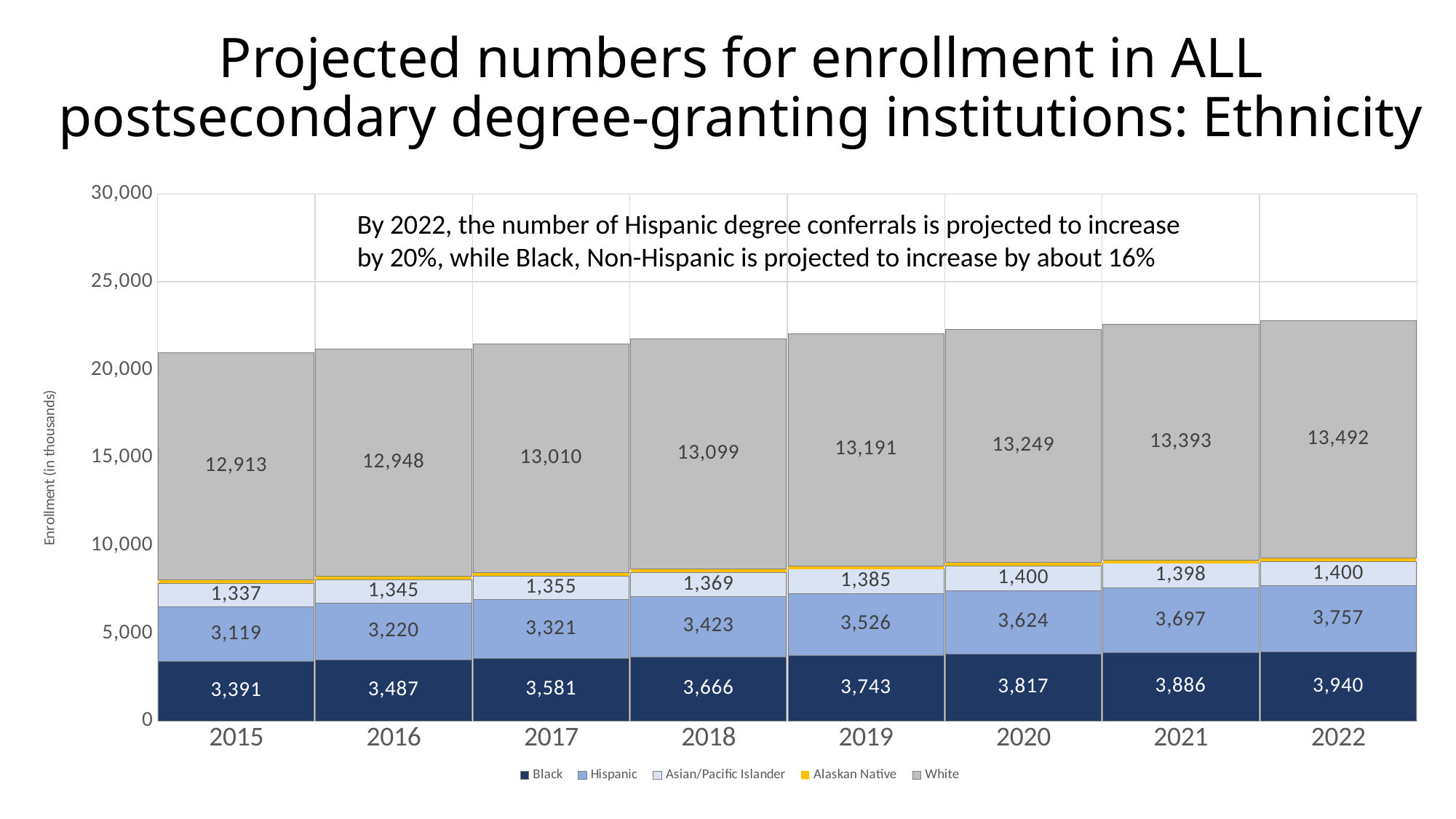
How many series does the legend list? 5 In which year is the projected Hispanic enrollment lowest? 2015 What kind of chart is shown on the slide? Stacked bar chart By how much does the projected Hispanic enrollment in 2022 exceed that in 2015? 638 What is the projected Black enrollment for 2015? 3,391 What is the projected White enrollment for 2022? 13,492 What is the projected Asian/Pacific Islander enrollment for 2019? 1,385 In which year is the projected Black enrollment highest? 2022 How many years are shown on the x axis? 8 What is the difference between the White and Black projected enrollment in 2020? 9,432 What is the projected Hispanic enrollment for 2018? 3,423 Which is larger in 2017: the projected Black enrollment or the projected Hispanic enrollment? Black